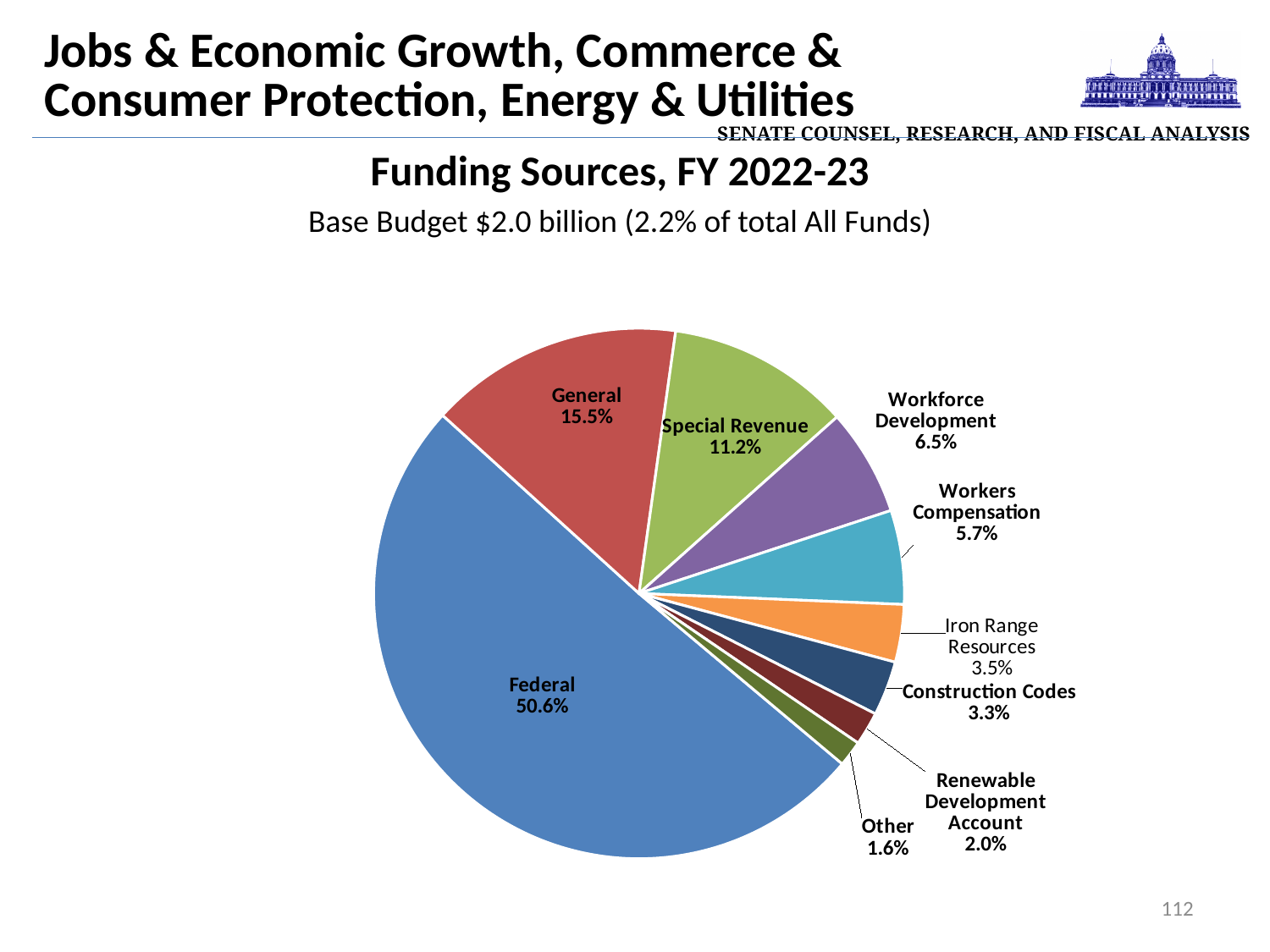
Which funding source has the smallest share of the pie? Other What is the difference in percentage points between the General and Special Revenue shares? 4.3 Which funding source has the largest share of the pie? Federal What is the title of the chart? Funding Sources, FY 2022-23 What percentage of funding is from Special Revenue? 11.2% What share of funding comes from the Federal source? 50.6% What percentage does Iron Range Resources account for? 3.5% What type of chart is shown on the slide? Pie chart What is the share for Workers Compensation? 5.7% How many funding sources are shown in the pie chart? 9 What is the combined share of Construction Codes and Renewable Development Account? 5.3% Which is larger, the Workforce Development share or the Workers Compensation share? Workforce Development